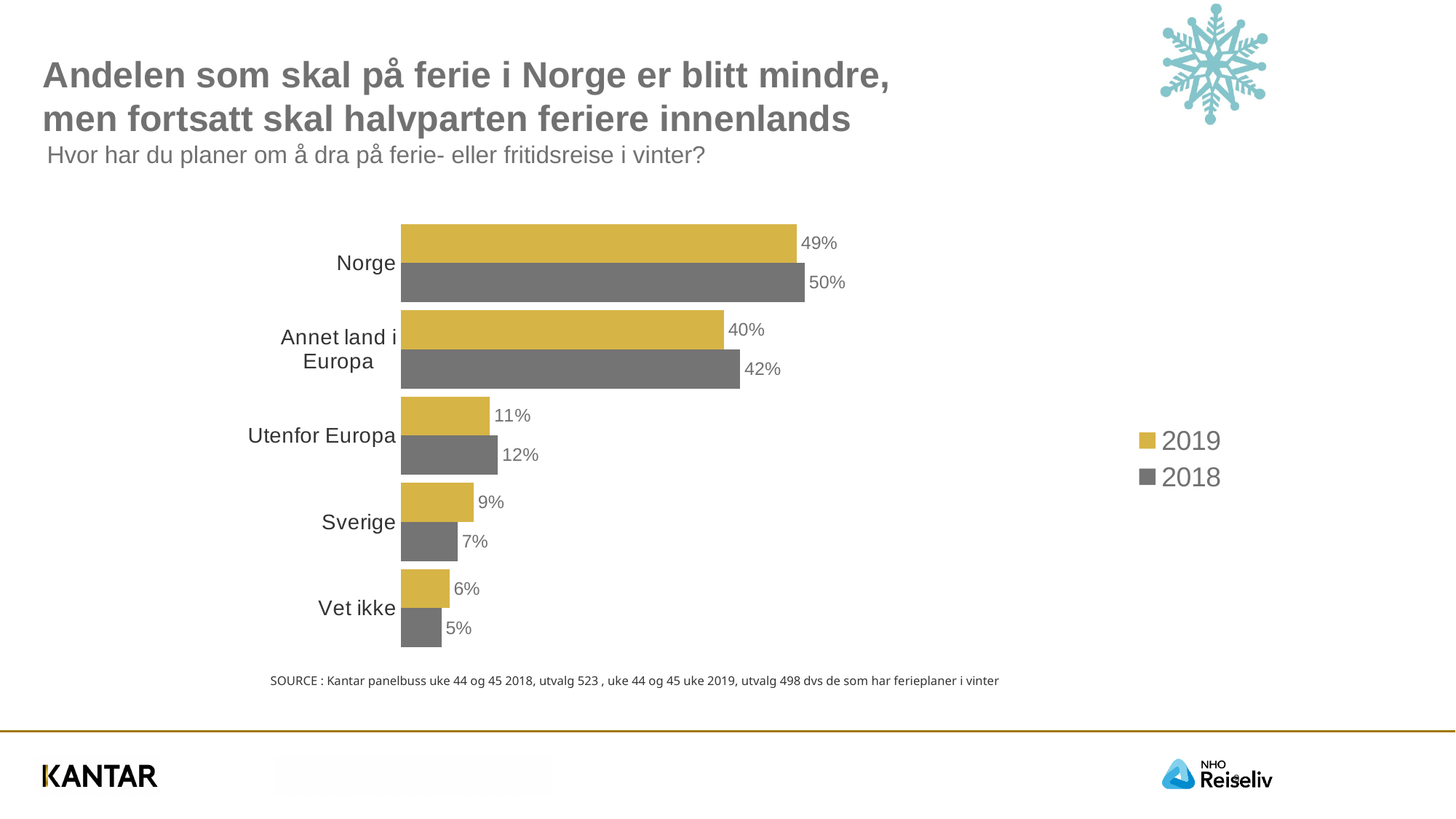
What is the value for Vet ikke in 2018? 5% What is the value for Norge in 2019? 49% Which colour represents the 2019 series in the legend? Yellow What kind of chart is shown on the slide? Bar chart Which is larger for Sverige, the 2019 value or the 2018 value? 2019 What is the value for Annet land i Europa in 2018? 42% What is the difference between the 2018 and 2019 values for Utenfor Europa? 1% How many categories are shown on the chart? 5 Which category has the highest value in 2018? Norge How many series does the legend list? 2 What is the value for Sverige in 2019? 9% Which category has the lowest value in 2019? Vet ikke